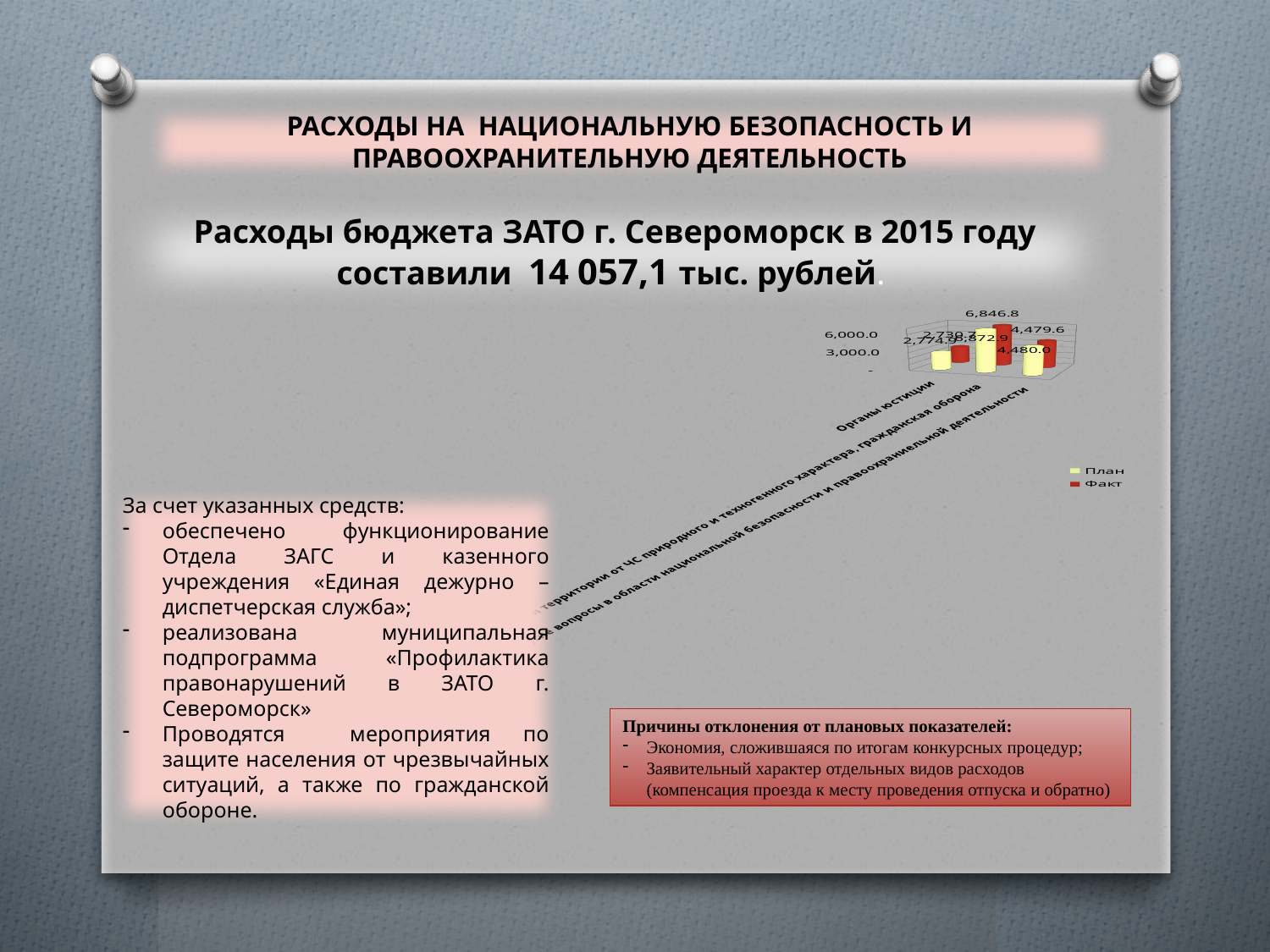
What is the largest data label value shown on the chart? 6,872.9 Which series is shown in red on the chart? Факт Is the highest value on the chart greater or less than 6,000.0? greater How many series does the chart legend list? 2 What are the two series named in the chart legend? План and Факт What kind of chart is shown on the slide? bar chart How many categories are shown on the chart's category axis? 3